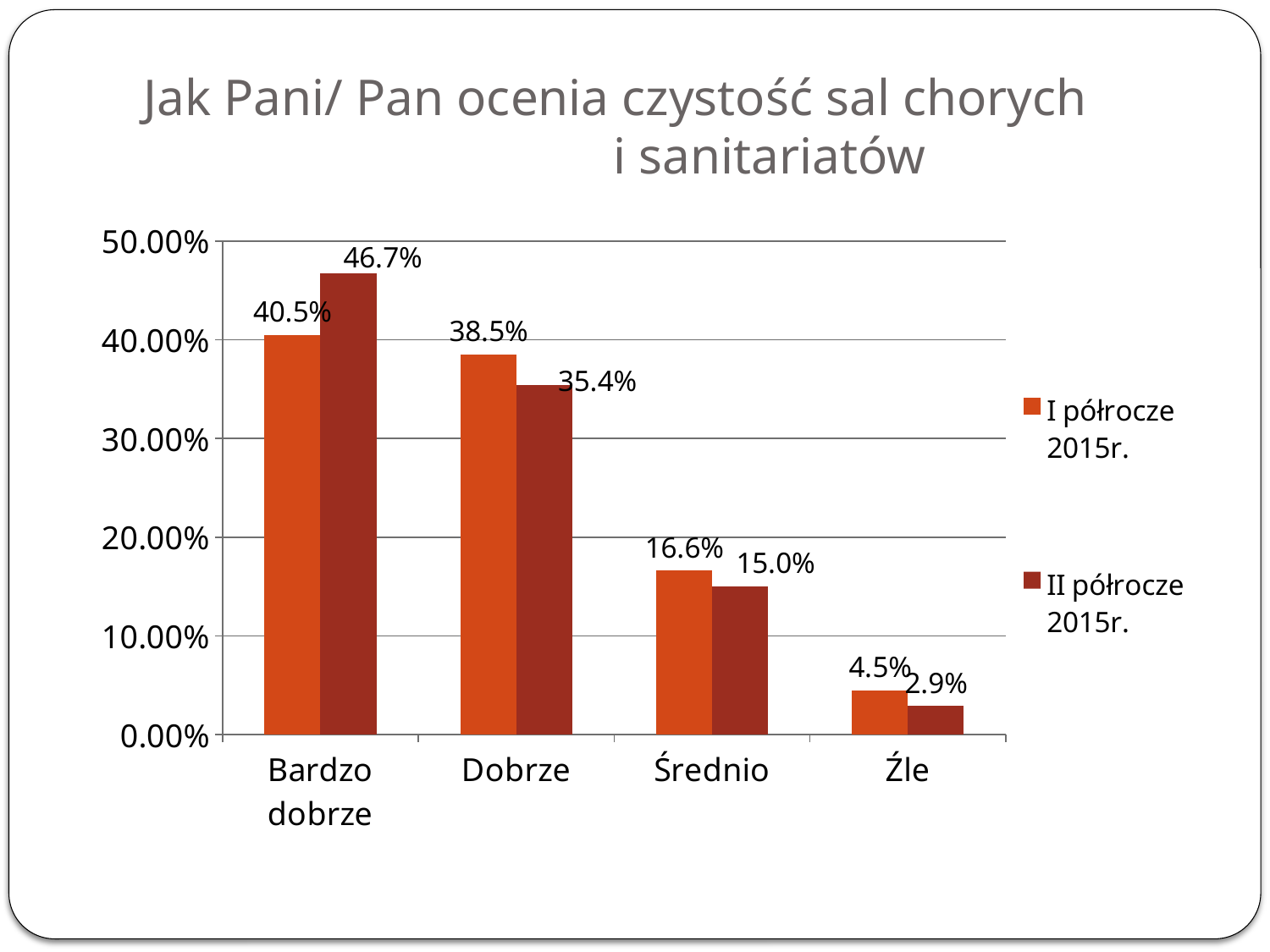
What is the difference between the "II półrocze 2015r." and "I półrocze 2015r." values for "Bardzo dobrze"? 6.2% What is the value for "Bardzo dobrze" in the "I półrocze 2015r." series? 40.5% What kind of chart is shown on the slide? bar chart Do the values in the "II półrocze 2015r." series rise or fall from left to right along the x axis? fall Is the value for "Dobrze" in the "I półrocze 2015r." series greater or less than 40.00%? less Which series has the larger value for "Średnio"? I półrocze 2015r. Which category has the highest value in the "II półrocze 2015r." series? Bardzo dobrze Which category has the lowest value in the "I półrocze 2015r." series? Źle What is the value for "Źle" in the "I półrocze 2015r." series? 4.5% What is the value for "Dobrze" in the "II półrocze 2015r." series? 35.4% How many series does the legend list? 2 How many categories are shown on the x axis? 4